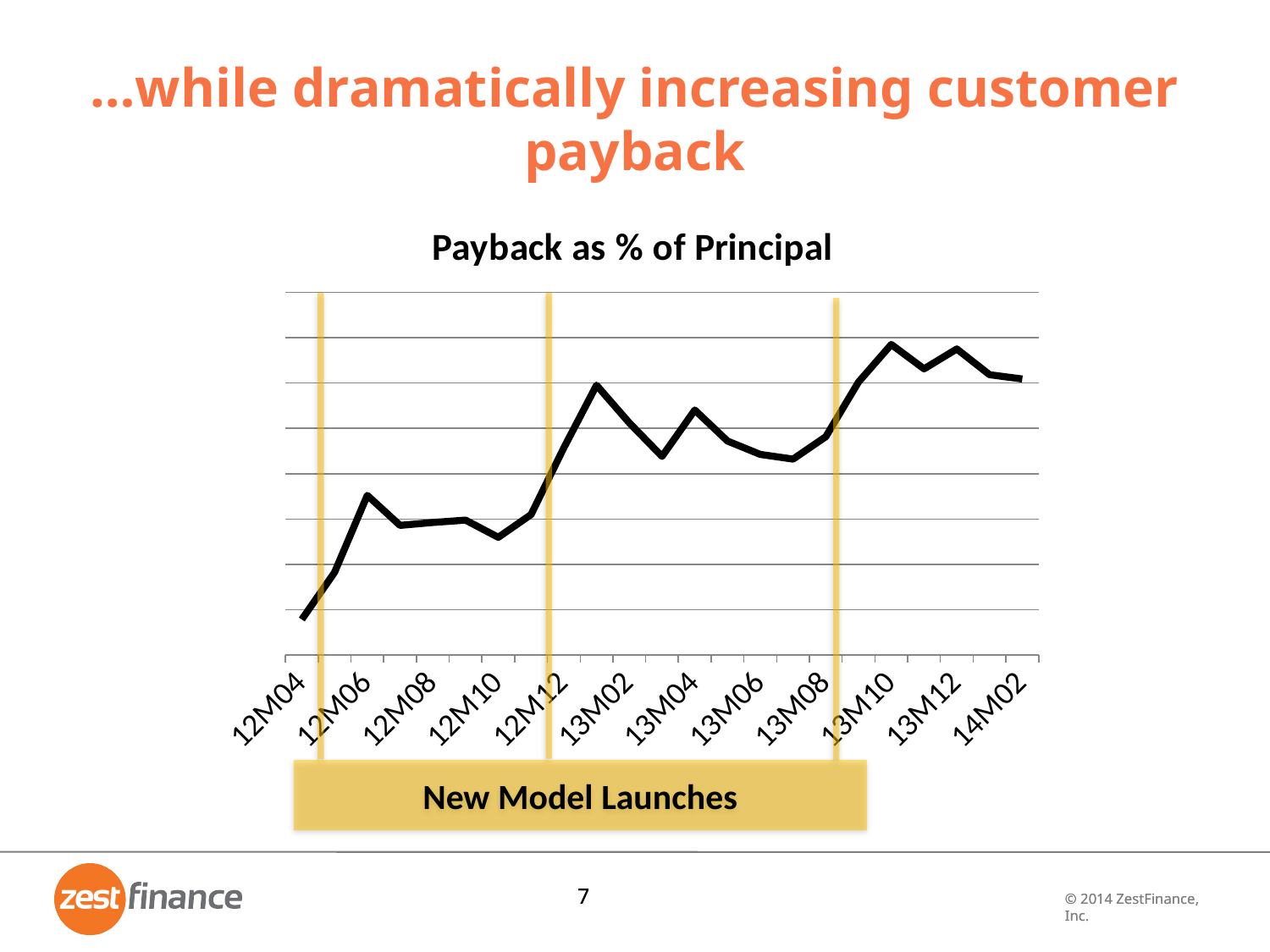
What kind of chart is shown on the slide? line chart Which has the larger payback value, 12M04 or 14M02? 14M02 What is the first label on the x axis of the chart? 12M04 At which x-axis label is the payback value lowest? 12M04 How many vertical lines marking new model launches are drawn on the chart? 3 What is the title of the chart? Payback as % of Principal Which has the larger payback value, 12M06 or 13M02? 13M02 What label appears in the box beneath the vertical lines on the chart? New Model Launches Overall, does the payback line rise or fall from 12M04 to 14M02? rise What is the last label on the x axis of the chart? 14M02 Which has the larger payback value, 13M08 or 13M10? 13M10 How many labels are shown on the x axis of the chart? 12